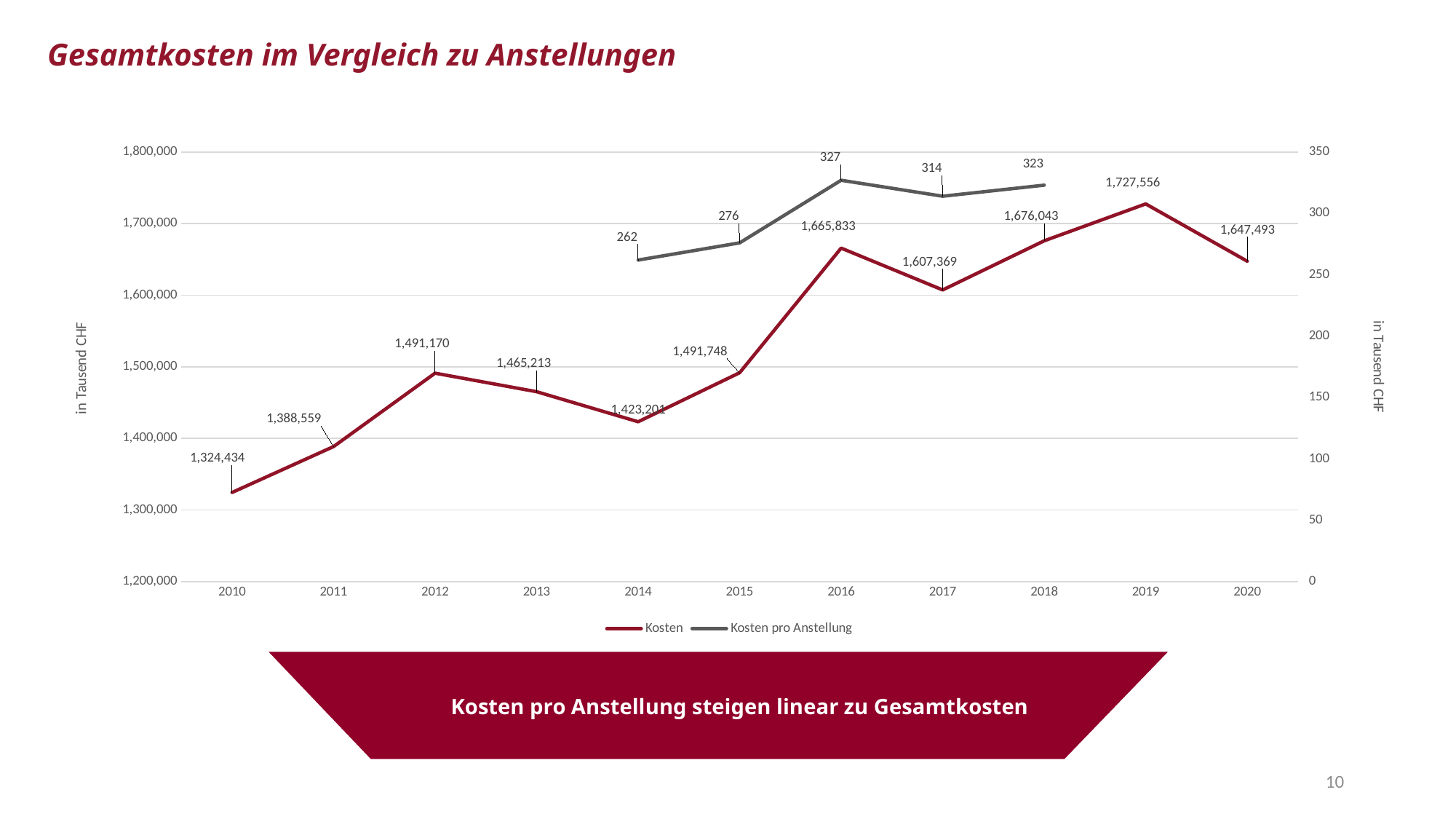
In which year does the Kosten series reach its highest value? 2019 What kind of chart is shown on the slide? Line chart What is the difference between the Kosten pro Anstellung values for 2016 and 2017? 13 What is the difference between the Kosten values for 2019 and 2020? 80,063 What is the value of the Kosten series for 2010? 1,324,434 What is the value of the Kosten pro Anstellung series for 2016? 327 Which year has the larger Kosten value, 2012 or 2013? 2012 How many series does the legend list? 2 In which year does the Kosten pro Anstellung series have its lowest value? 2014 How many years are shown on the x axis? 11 What is the value of the Kosten series for 2019? 1,727,556 What is the title of the chart on the slide? Gesamtkosten im Vergleich zu Anstellungen